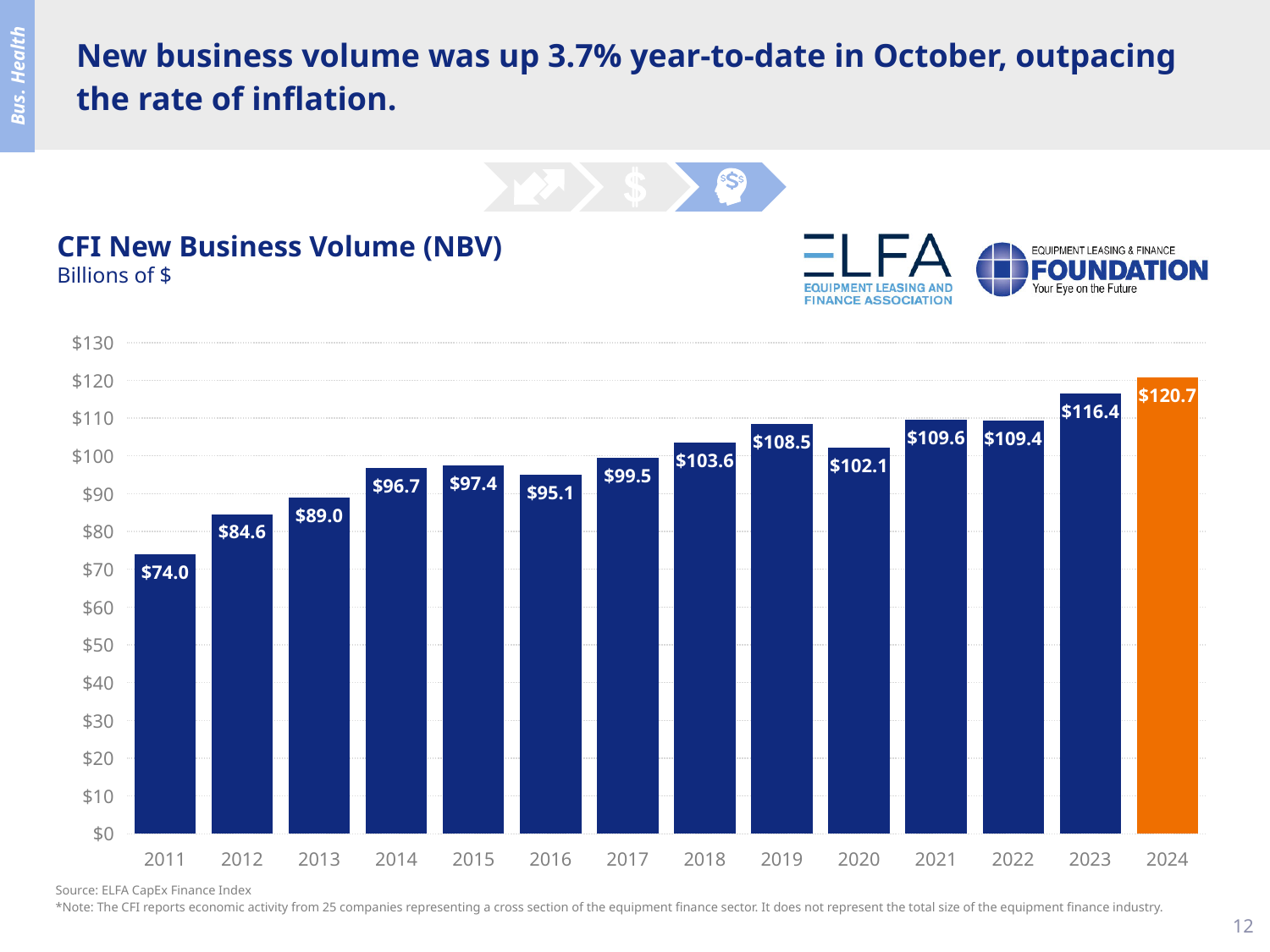
Which year has a larger CFI New Business Volume, 2015 or 2016? 2015 What is the CFI New Business Volume for 2024? $120.7 Which year has the highest CFI New Business Volume? 2024 What is the CFI New Business Volume for 2011? $74.0 Which year has the lowest CFI New Business Volume? 2011 What is the difference between the CFI New Business Volume in 2019 and in 2020? $6.4 What is the CFI New Business Volume for 2020? $102.1 What unit is the CFI New Business Volume chart measured in, according to its subtitle? Billions of $ Is the CFI New Business Volume for 2013 greater or less than $90? less What is the difference between the CFI New Business Volume in 2024 and in 2023? $4.3 How many years are shown on the CFI New Business Volume chart? 14 What kind of chart is used to show CFI New Business Volume? Bar chart